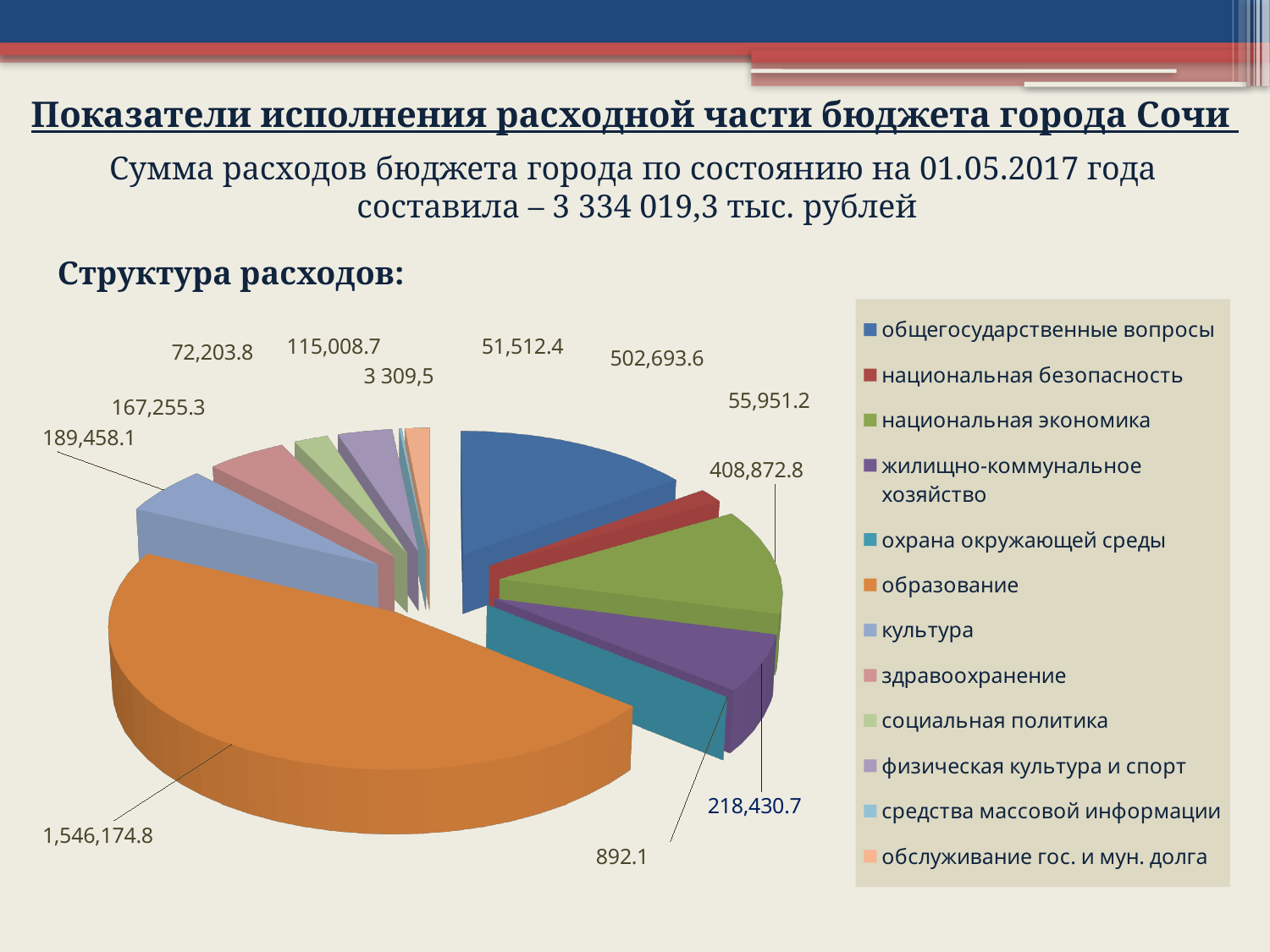
What is the value shown for общегосударственные вопросы? 502,693.6 What kind of chart is shown on the slide? pie chart What is the value shown for физическая культура и спорт? 115,008.7 How many categories does the legend of the pie chart list? 12 What heading is printed directly above the pie chart? Структура расходов: What is the value shown for культура? 189,458.1 What is the value shown for национальная экономика? 408,872.8 What is the value shown for образование? 1,546,174.8 Which is larger, the value for общегосударственные вопросы or the value for национальная экономика? общегосударственные вопросы What is the difference between the value for образование and the value for общегосударственные вопросы? 1,043,481.2 Which category has the largest slice in the pie chart? образование What is the value shown for здравоохранение? 167,255.3